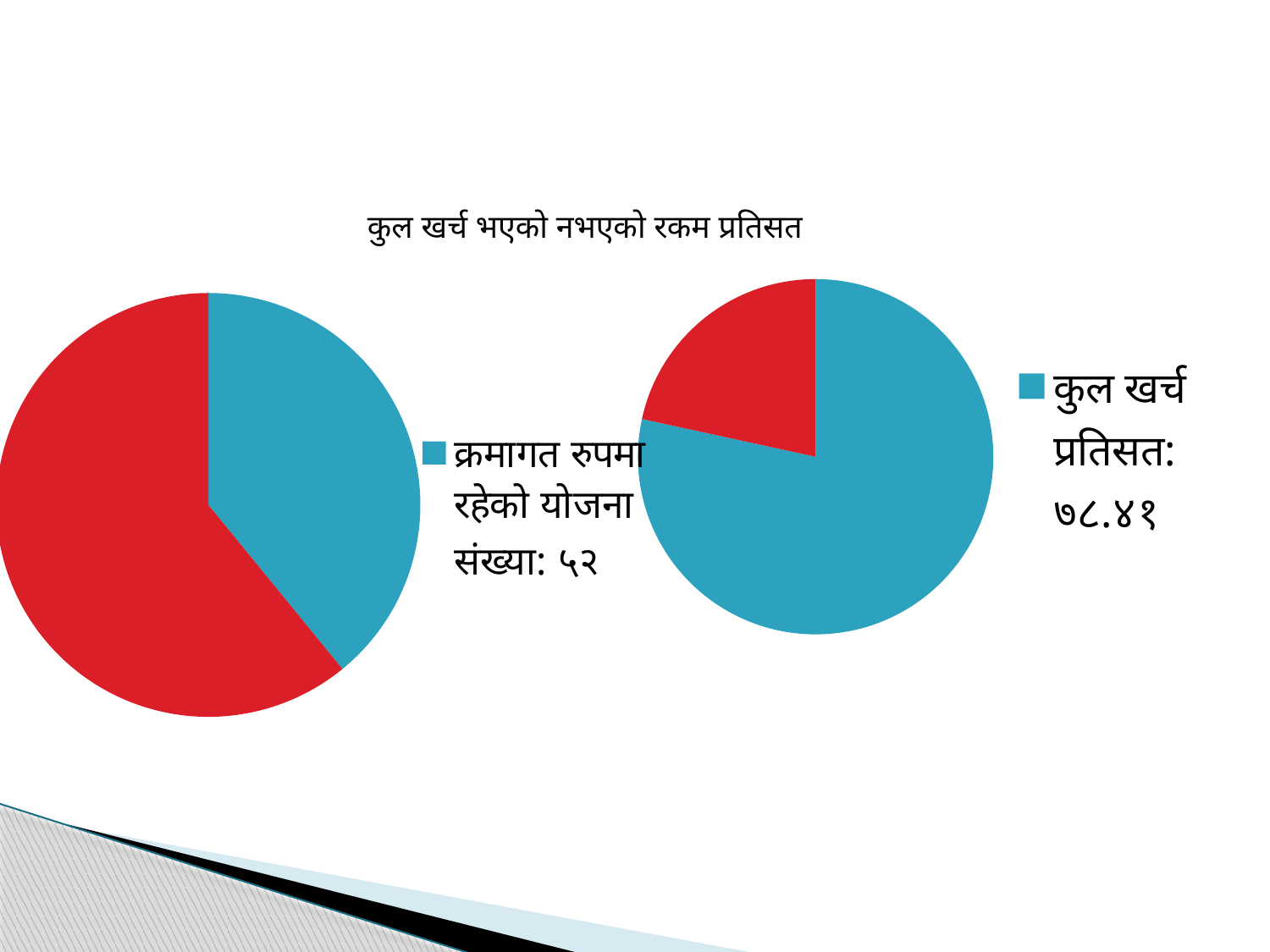
What kind of chart is the chart on the left of the slide? pie chart In the chart on the left, what legend entry is shown for the blue slice? क्रमागत रुपमा रहेको योजना संख्या: ५२ How many pie charts are on the slide? 2 In the chart on the right, what legend entry is shown for the blue slice? कुल खर्च प्रतिसत: ७८.४१ What kind of chart is the chart on the right of the slide? pie chart In the chart on the right, what value is printed in the legend for कुल खर्च प्रतिसत? ७८.४१ In the chart on the right, which slice is larger, the blue slice or the red slice? the blue slice How many slices does the pie chart on the left have? 2 How many slices does the pie chart on the right have? 2 In the chart on the left, what value is printed in the legend for क्रमागत रुपमा रहेको योजना संख्या? ५२ In the chart on the left, which slice is larger, the blue slice or the red slice? the red slice